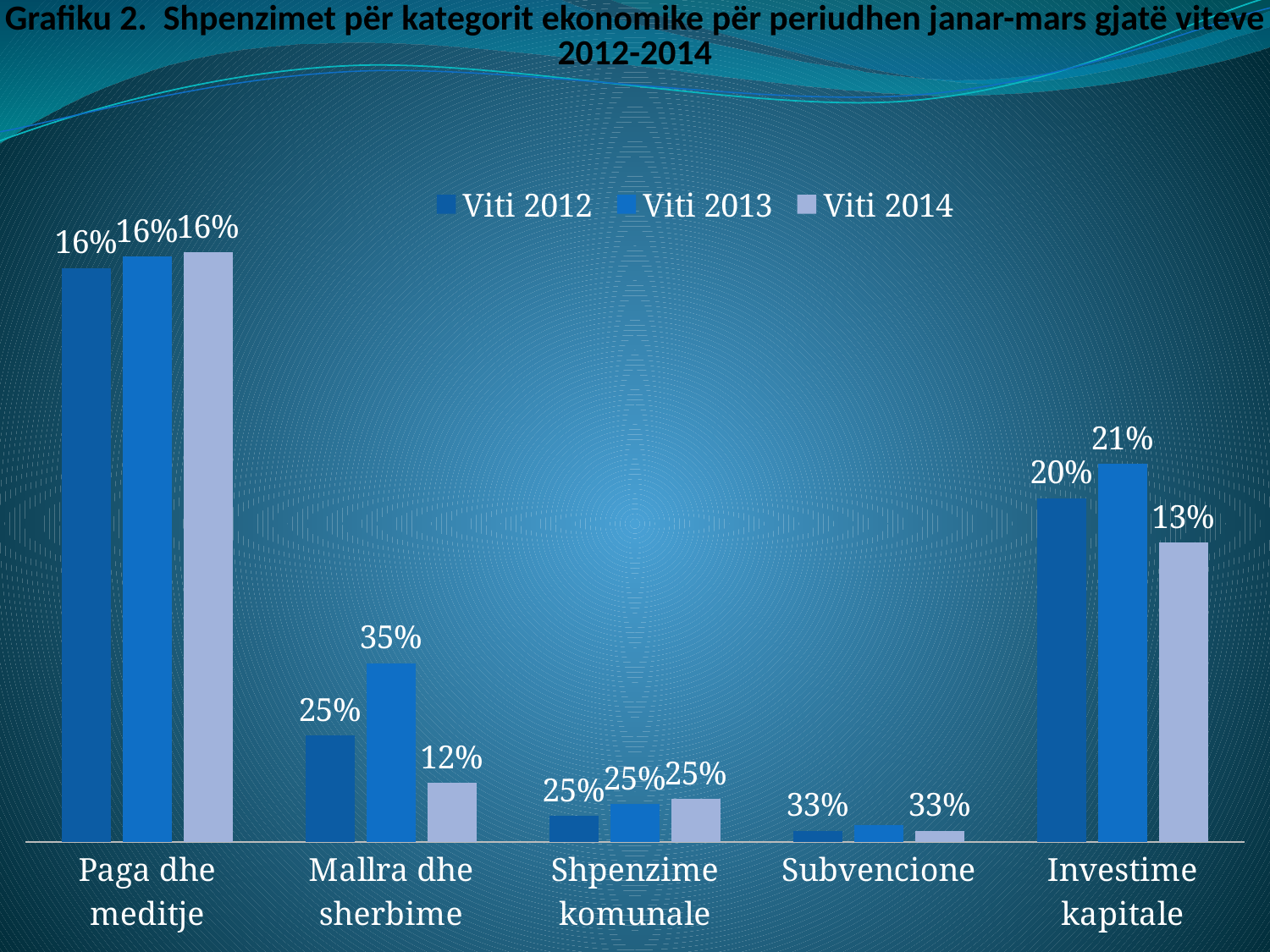
Which is larger in the Mallra dhe sherbime category: the value for Viti 2013 or for Viti 2014? Viti 2013 What is the value for Viti 2012 in the Investime kapitale category? 20% What is the value for Viti 2014 in the Mallra dhe sherbime category? 12% What type of chart is shown on the slide? bar chart What is the value for Viti 2014 in the Subvencione category? 33% How many series does the legend list? 3 How many categories are shown on the x axis? 5 What is the value for Viti 2013 in the Mallra dhe sherbime category? 35% What is the value for Viti 2012 in the Paga dhe meditje category? 16% Which is larger in the Investime kapitale category: the value for Viti 2013 or for Viti 2014? Viti 2013 What are the three series names listed in the legend? Viti 2012, Viti 2013, Viti 2014 What is the value for Viti 2014 in the Investime kapitale category? 13%